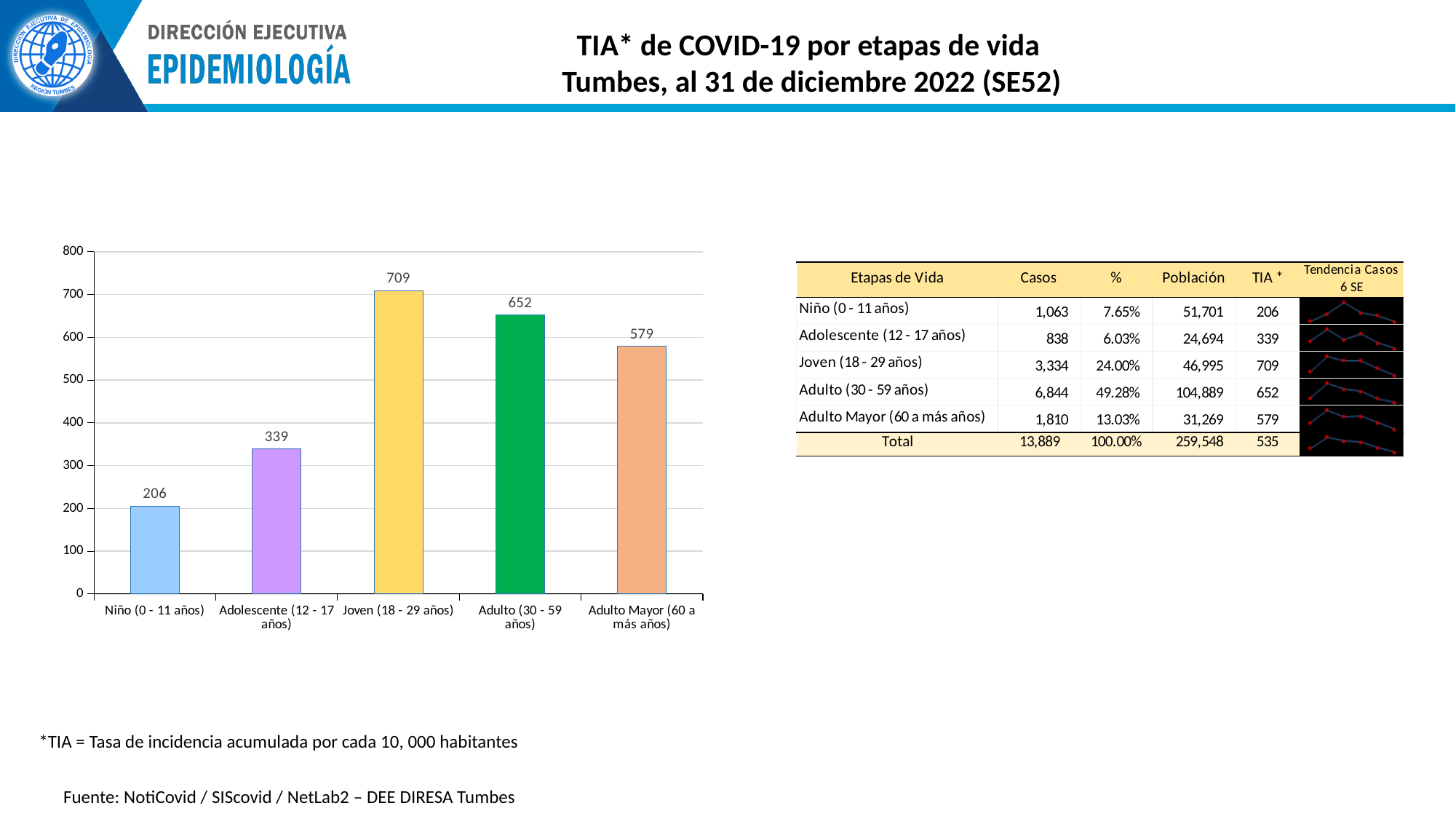
Is the TIA value for Adolescente (12 - 17 años) greater or less than 400? less How many life-stage categories are shown in the bar chart? 5 What is the TIA value for Joven (18 - 29 años) in the bar chart? 709 What kind of chart is used to show TIA by life stage? bar chart Which life stage has the lowest TIA in the bar chart? Niño (0 - 11 años) What is the difference between the TIA for Joven (18 - 29 años) and Adulto (30 - 59 años)? 57 What is the TIA value for Niño (0 - 11 años) in the bar chart? 206 What is the difference between the TIA for Adolescente (12 - 17 años) and Niño (0 - 11 años)? 133 Which is larger, the TIA for Adulto (30 - 59 años) or for Adulto Mayor (60 a más años)? Adulto (30 - 59 años) What is the TIA value for Adulto Mayor (60 a más años) in the bar chart? 579 Which life stage has the highest TIA in the bar chart? Joven (18 - 29 años) What colour is the bar for Adulto (30 - 59 años)? green